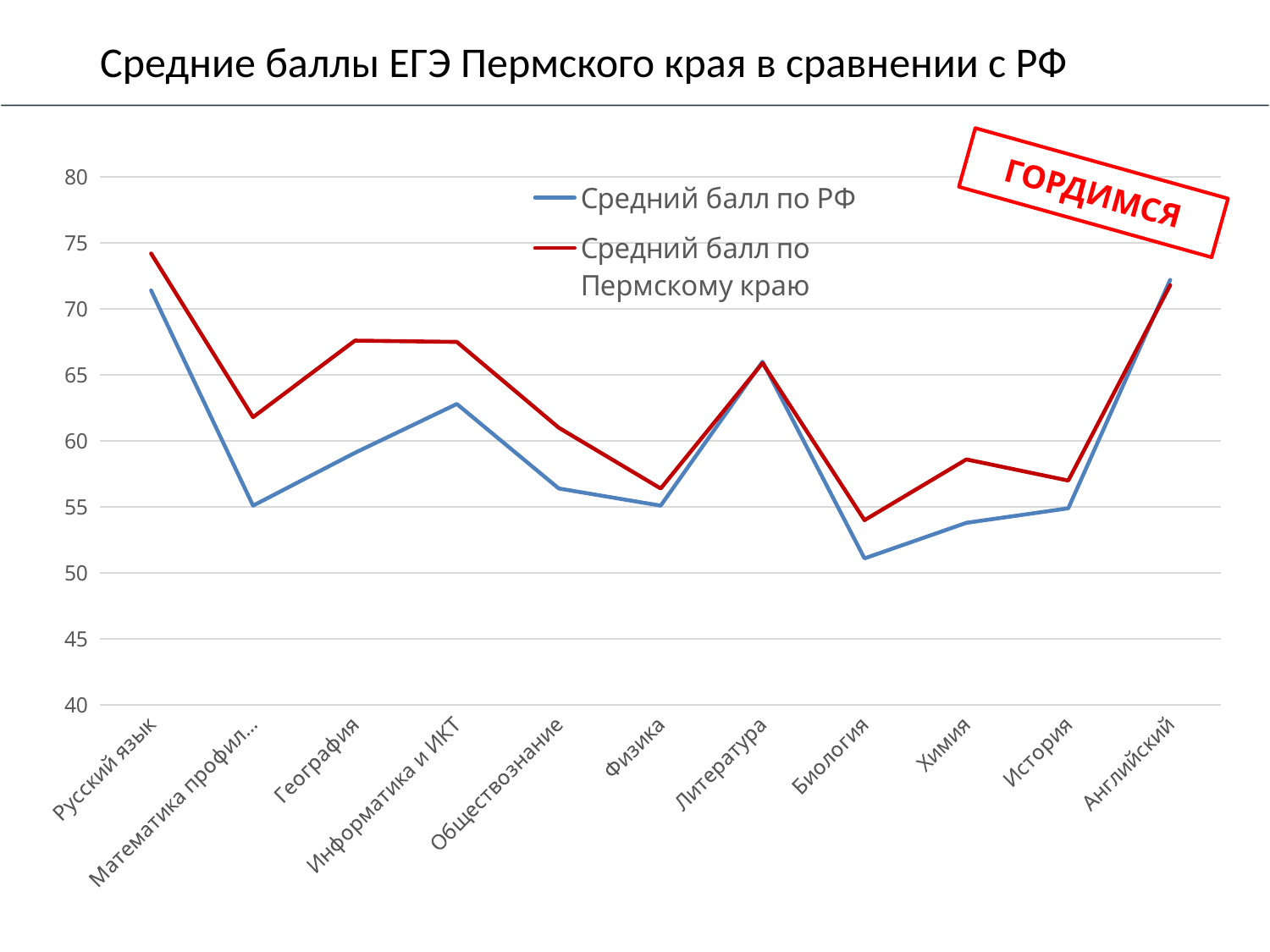
Which subject has the lowest value for the series 'Средний балл по РФ'? Биология For География, which series has the larger value: 'Средний балл по РФ' or 'Средний балл по Пермскому краю'? Средний балл по Пермскому краю Is the value for Биология in the series 'Средний балл по РФ' greater or less than 55? less Which subject has the highest value for the series 'Средний балл по Пермскому краю'? Русский язык What colour is the line for 'Средний балл по Пермскому краю'? red Do the values for 'Средний балл по РФ' rise or fall from Биология to Английский? rise Which subject has the lowest value for the series 'Средний балл по Пермскому краю'? Биология Is the value for География in the series 'Средний балл по Пермскому краю' greater or less than 65? greater How many subjects are plotted along the x axis? 11 What kind of chart is shown on the slide? line chart Is the value for Русский язык in the series 'Средний балл по Пермскому краю' greater or less than 70? greater How many series does the legend list? 2